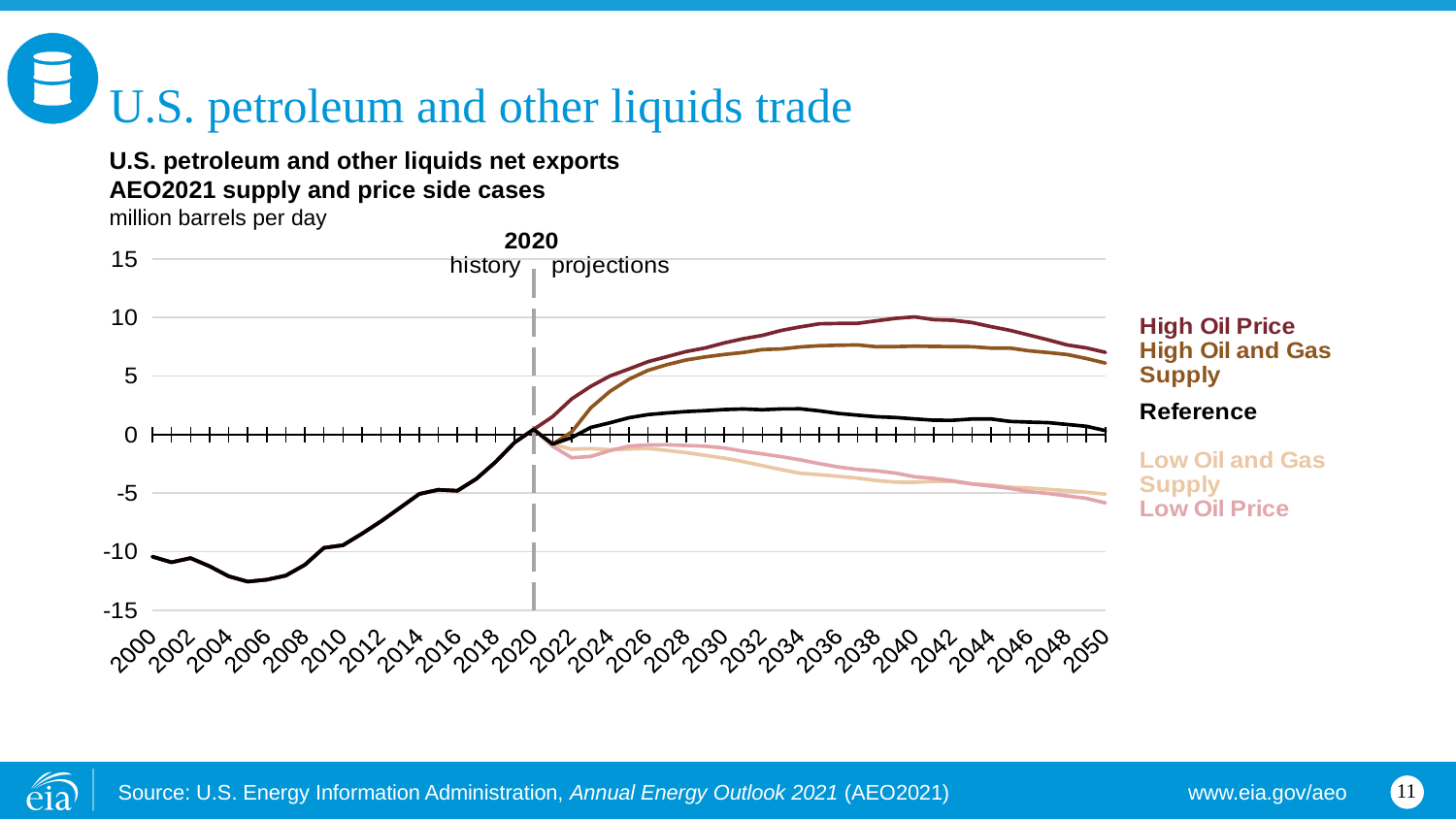
Which year separates history from projections on the chart? 2020 How many series (cases) does the chart's legend list? 5 Is the historical value in 2005 greater or less than -10? less Is the value for the Low Oil Price case in 2050 greater or less than 0? less In 2050, which is larger: the High Oil Price case or the High Oil and Gas Supply case? High Oil Price Which case has the highest net exports in 2040? High Oil Price What unit is the chart's y axis measured in? million barrels per day Is the value for the Reference case in 2050 greater or less than 5? less Which case has the lowest net exports in 2050? Low Oil Price Do net exports rise or fall between 2000 and 2020 in the historical data? rise What kind of chart is shown on the slide? line chart